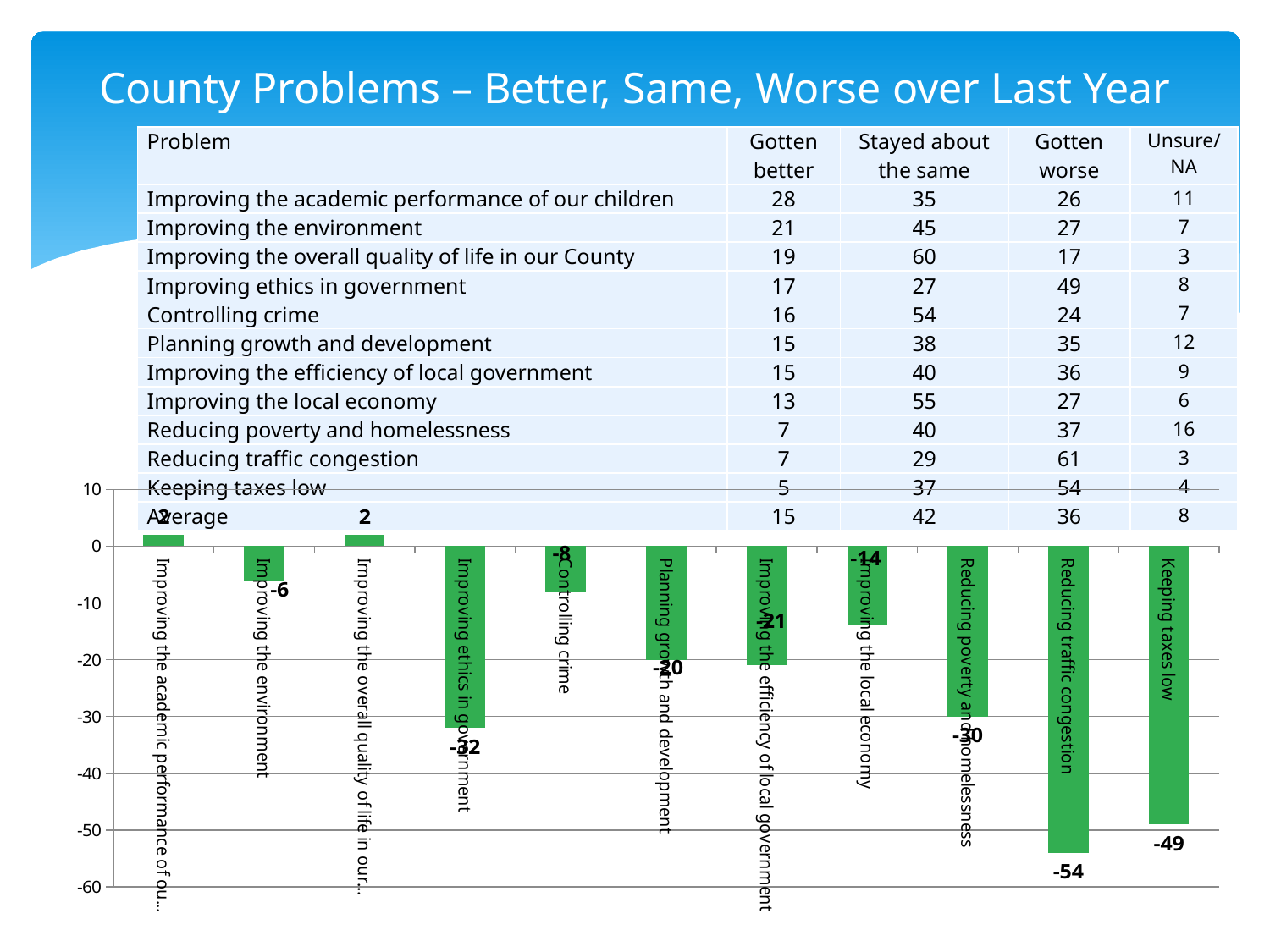
What type of chart is shown on the slide? bar chart What colour are the bars in the chart? green What is the value for Keeping taxes low in the chart? -49 What is the value for Improving ethics in government in the chart? -32 Which category has the lowest value in the chart? Reducing traffic congestion What is the value for Improving the local economy in the chart? -14 How many categories (bars) does the chart show? 11 Which has a higher value in the chart, Improving the environment or Improving the efficiency of local government? Improving the environment Is the value for Reducing poverty and homelessness greater or less than -20? less What is the difference between the values for Reducing poverty and homelessness and Planning growth and development? 10 What is the value for Reducing traffic congestion in the chart? -54 What is the value for Controlling crime in the chart? -8